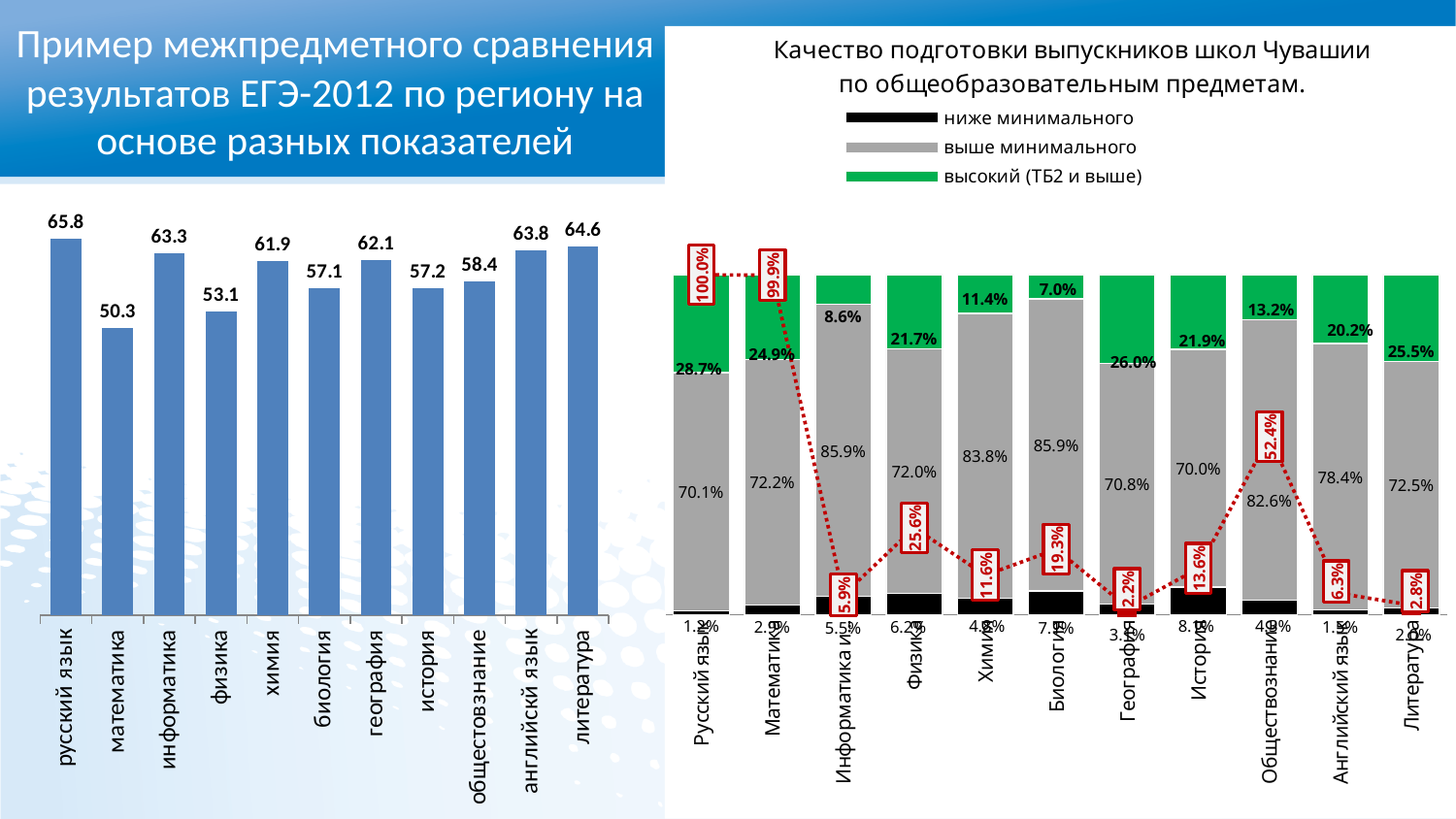
In the chart titled 'Качество подготовки выпускников школ Чувашии по общеобразовательным предметам', how many series does the legend list? 3 What type of chart is the left chart? bar chart How many subjects are shown in the left chart? 11 In the left chart, which is larger: the value for химия or the value for биология? химия In the chart titled 'Качество подготовки выпускников школ Чувашии по общеобразовательным предметам', which subject has the lowest 'высокий (ТБ2 и выше)' value? Биология In the left chart, what is the difference between the values for информатика and физика? 10.2 In the left chart, which subject has the highest value? русский язык In the left chart, what is the value for русский язык? 65.8 In the chart titled 'Качество подготовки выпускников школ Чувашии по общеобразовательным предметам', what is the 'выше минимального' value for Химия? 83.8% In the chart titled 'Качество подготовки выпускников школ Чувашии по общеобразовательным предметам', what is the 'высокий (ТБ2 и выше)' value for Русский язык? 28.7% In the left chart, what is the value for математика? 50.3 In the left chart, which subject has the lowest value? математика